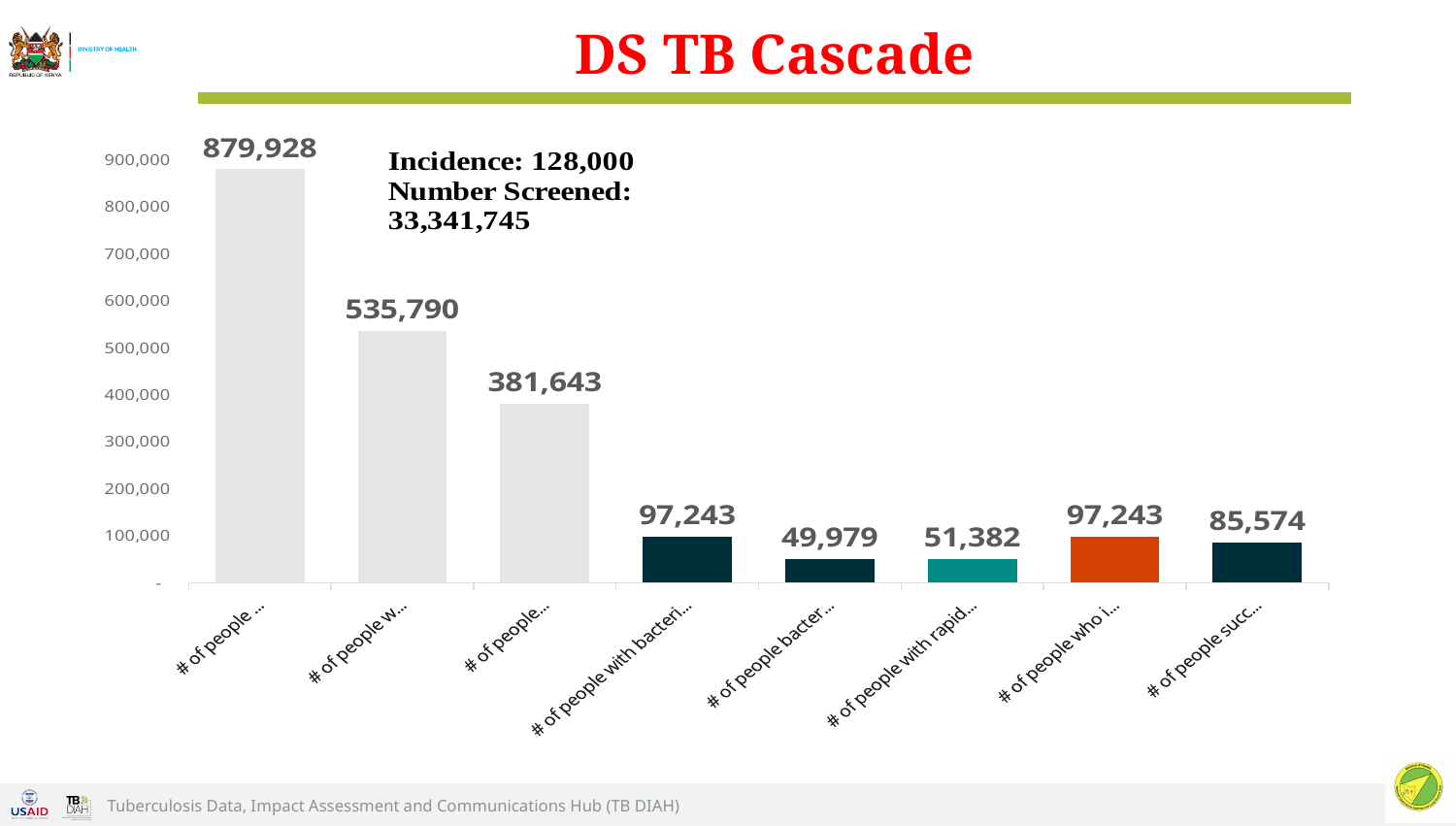
What is the value of the second bar in the DS TB Cascade chart? 535,790 What is the value of the third bar in the DS TB Cascade chart? 381,643 What incidence figure is stated in the text box on the DS TB Cascade chart? 128,000 What is the value of the last (rightmost) bar in the DS TB Cascade chart? 85,574 What is the Number Screened stated on the DS TB Cascade slide? 33,341,745 In the DS TB Cascade chart, which is larger: the fifth bar or the sixth bar? the sixth bar (51,382) What type of chart is shown on the DS TB Cascade slide? bar chart What is the value of the first (leftmost) bar in the DS TB Cascade chart? 879,928 Which bar has the highest value in the DS TB Cascade chart? the first (leftmost) bar, 879,928 What is the difference between the first bar (879,928) and the second bar (535,790) in the DS TB Cascade chart? 344,138 How many bars are plotted in the DS TB Cascade chart? 8 Which bar has the lowest value in the DS TB Cascade chart? the fifth bar, 49,979